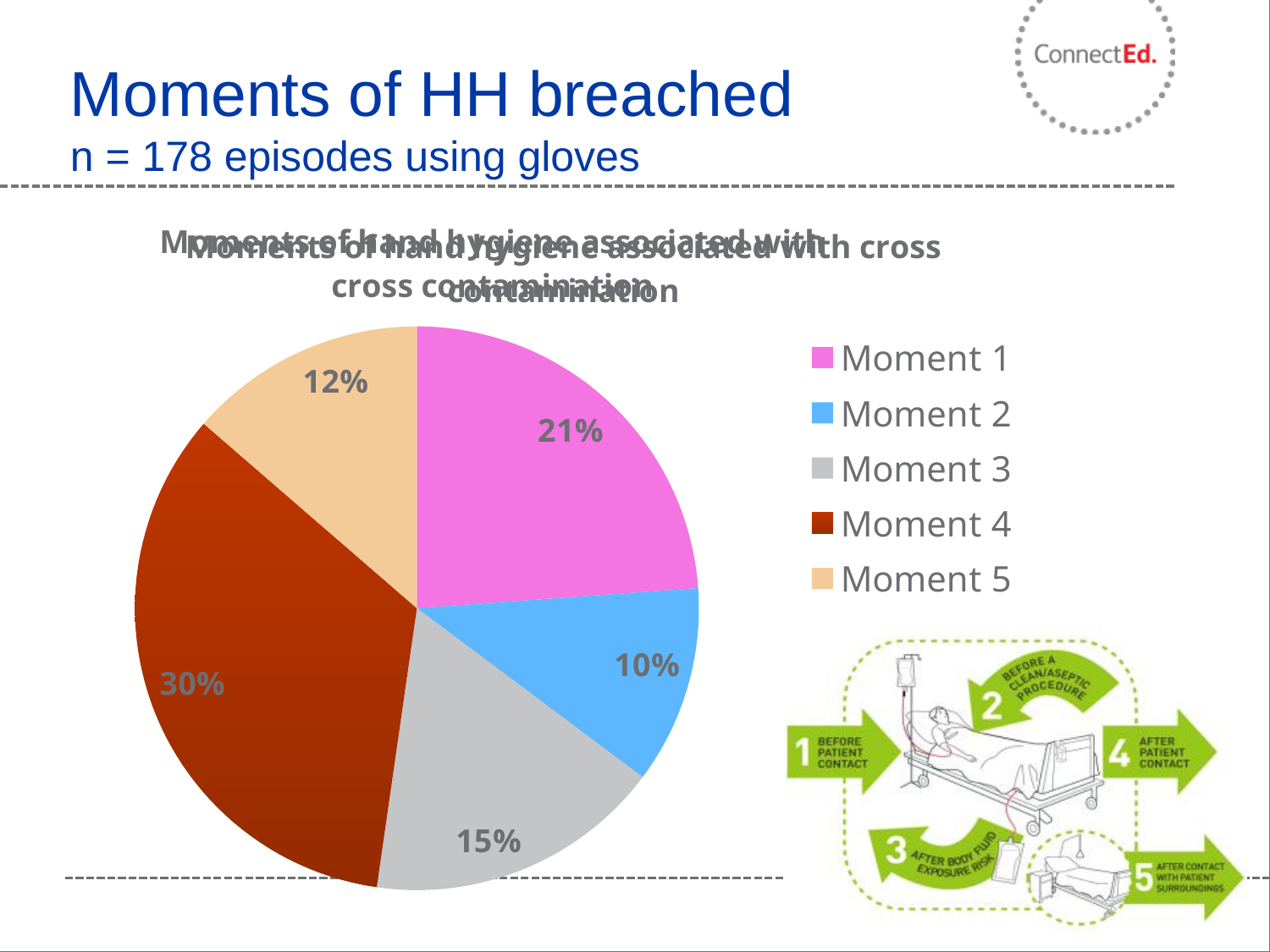
Which moment has the largest share of the pie? Moment 4 How many slices does the pie chart have? 5 What percentage of the pie is Moment 5? 12% What colour is the slice for Moment 4? dark red What percentage of the pie is Moment 4? 30% What percentage of the pie is Moment 1? 21% What percentage of the pie is Moment 2? 10% What percentage of the pie is Moment 3? 15% What is the difference in percentage points between Moment 4 and Moment 1? 9 What type of chart is shown on the slide? pie chart Which has a larger share, Moment 3 or Moment 5? Moment 3 Which moment has the smallest share of the pie? Moment 2